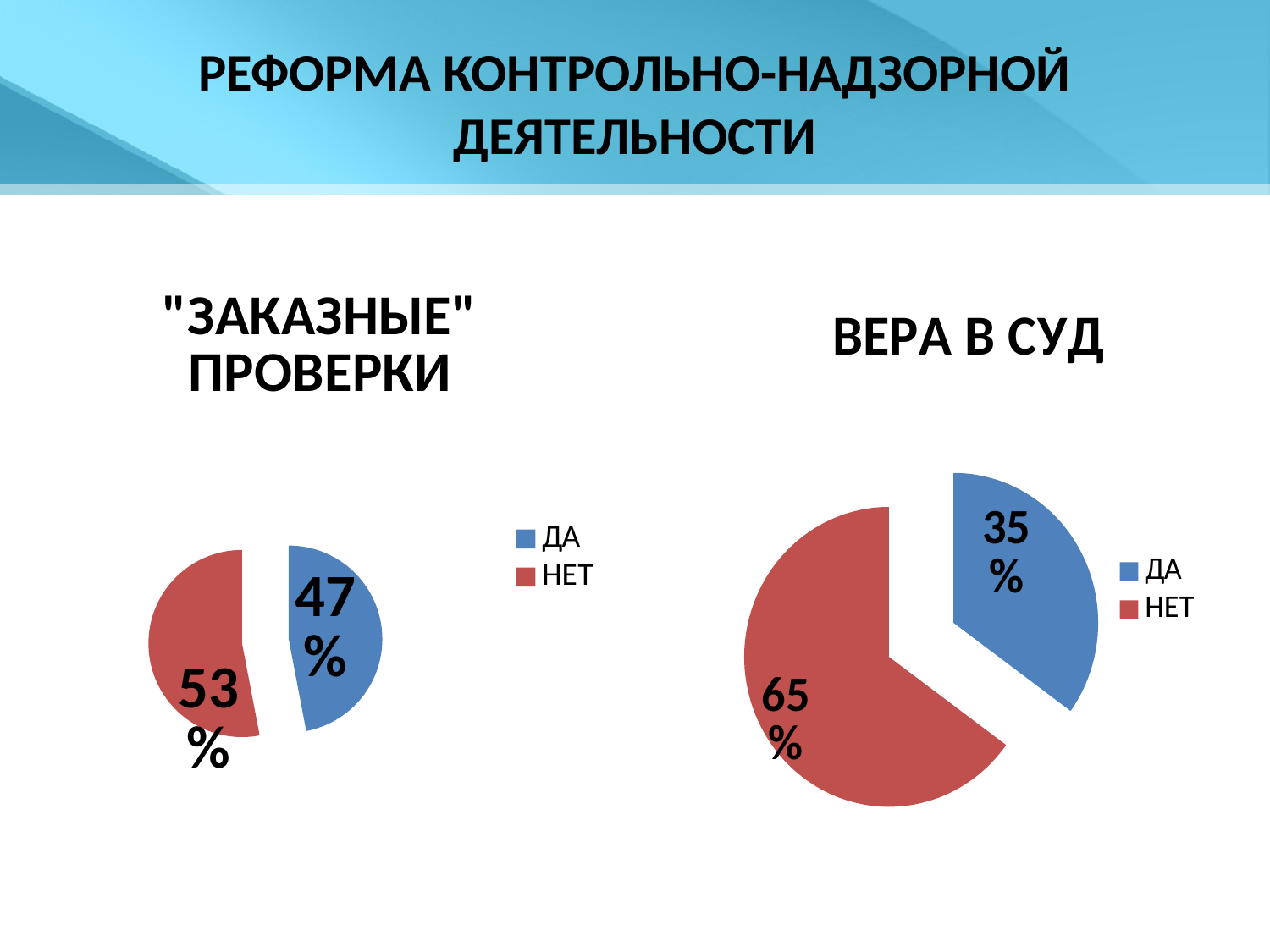
In the "ЗАКАЗНЫЕ" ПРОВЕРКИ chart, which slice is the smallest? ДА How many slices does the "ЗАКАЗНЫЕ" ПРОВЕРКИ chart have? 2 In the ВЕРА В СУД chart, what colour is the НЕТ slice? Red In the ВЕРА В СУД chart, what share is labelled ДА? 35% In the ВЕРА В СУД chart, which slice is the largest? НЕТ What kind of chart is the ВЕРА В СУД chart? Pie chart In the "ЗАКАЗНЫЕ" ПРОВЕРКИ chart, what share is labelled НЕТ? 53% In the "ЗАКАЗНЫЕ" ПРОВЕРКИ chart, what share is labelled ДА? 47% In the ВЕРА В СУД chart, what share is labelled НЕТ? 65% Is the ДА share larger in the "ЗАКАЗНЫЕ" ПРОВЕРКИ chart or in the ВЕРА В СУД chart? "ЗАКАЗНЫЕ" ПРОВЕРКИ In the "ЗАКАЗНЫЕ" ПРОВЕРКИ chart, what is the difference between the НЕТ and ДА shares? 6% In the ВЕРА В СУД chart, what is the difference between the НЕТ and ДА shares? 30%